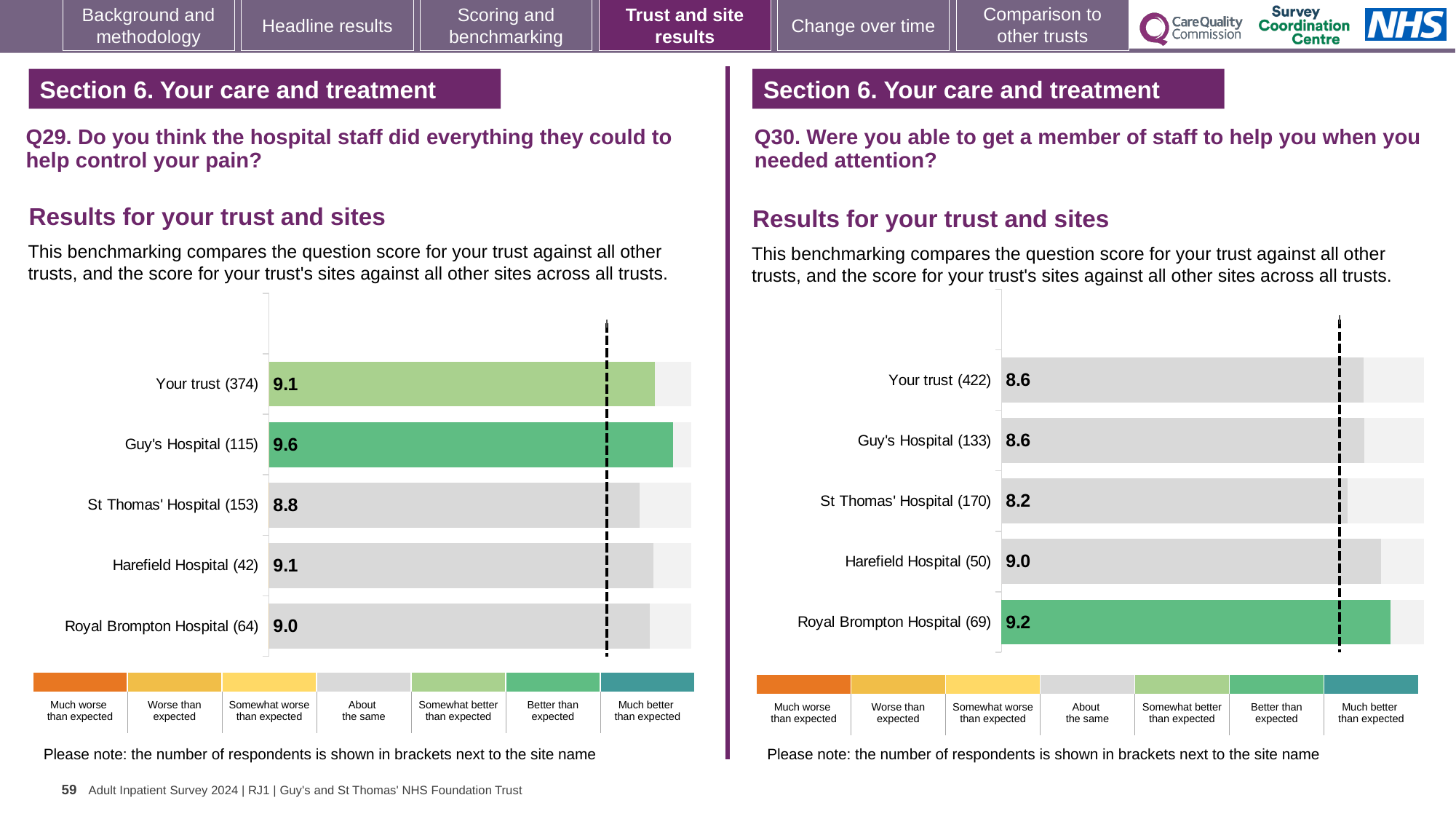
What type of chart is used for the Q29 results on the left? Bar chart In the Q29 chart on the left, what is the difference between the scores for Guy's Hospital and St Thomas' Hospital? 0.8 In the Q29 chart on the left, which site has the highest score? Guy's Hospital In the Q30 chart on the right, which is larger, the score for Harefield Hospital or the score for St Thomas' Hospital? Harefield Hospital In the Q29 chart on the left, what is the score for Guy's Hospital? 9.6 In the Q30 chart on the right, which site has the lowest score? St Thomas' Hospital In the Q30 chart on the right, what is the difference between the scores for Royal Brompton Hospital and Your trust? 0.6 In the Q29 chart on the left, how many bars are plotted? 5 In the Q29 chart on the left, what is the score for St Thomas' Hospital? 8.8 In the Q29 chart on the left, which site has the lowest score? St Thomas' Hospital In the Q30 chart on the right, what is the score for Your trust? 8.6 In the Q30 chart on the right, what is the score for Royal Brompton Hospital? 9.2